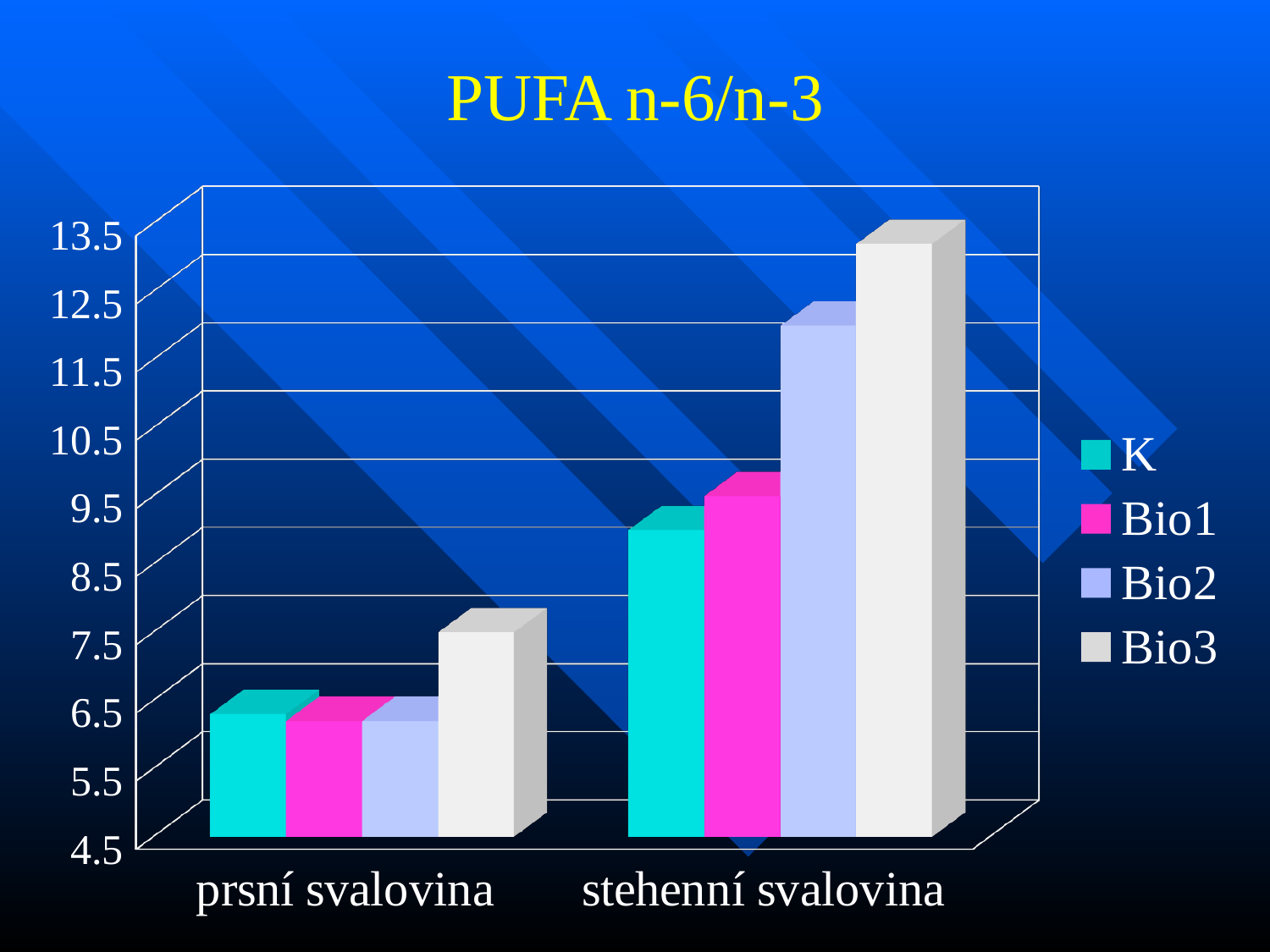
Is the value for Bio3 in stehenní svalovina greater or less than 12.5? greater Which series has the highest value for prsní svalovina? Bio3 How many series does the legend list? 4 What is the title of the chart? PUFA n-6/n-3 Which series are listed in the legend? K, Bio1, Bio2, Bio3 What kind of chart is shown on the slide? bar chart Is the value for Bio2 in stehenní svalovina greater or less than 11.5? greater Which is larger: the value for Bio3 or the value for K in stehenní svalovina? Bio3 Is the value for Bio1 in prsní svalovina greater or less than 7.5? less How many categories are shown on the x axis? 2 Which category has the higher values overall, prsní svalovina or stehenní svalovina? stehenní svalovina Which series has the highest value for stehenní svalovina? Bio3